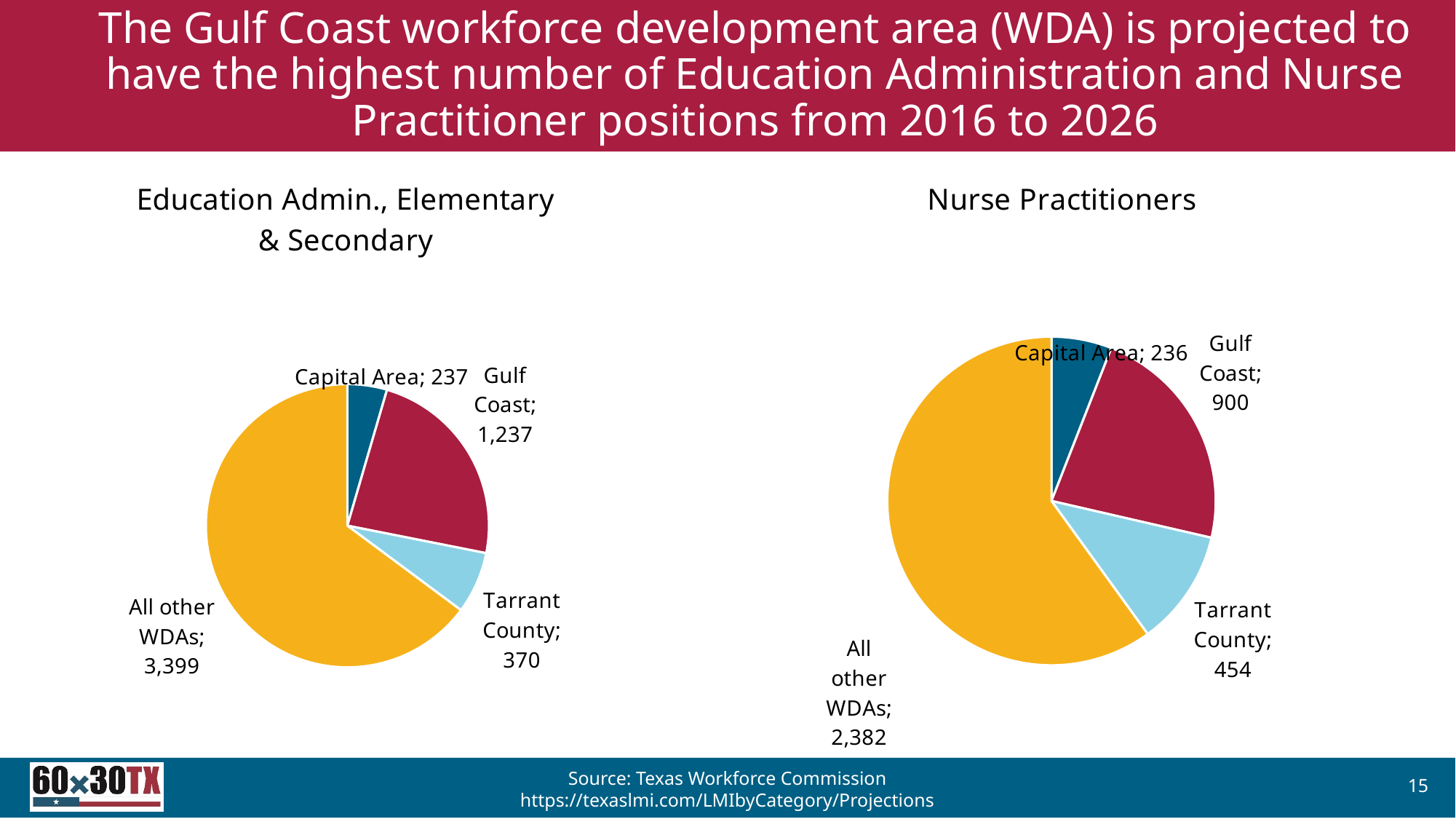
In the Education Admin., Elementary & Secondary chart, which slice is the smallest? Capital Area In the Nurse Practitioners chart, how many positions are projected for Tarrant County? 454 In the Nurse Practitioners chart, is the Gulf Coast value larger than the Tarrant County value? Yes Which is larger: Tarrant County in the Education Admin., Elementary & Secondary chart or Tarrant County in the Nurse Practitioners chart? Nurse Practitioners In the Nurse Practitioners chart, which slice is the largest? All other WDAs How many slices does the Nurse Practitioners pie chart have? 4 What is the total of all slices in the Nurse Practitioners chart? 3,972 What is the difference between the Gulf Coast values in the Education Admin., Elementary & Secondary chart and the Nurse Practitioners chart? 337 What type of chart is used for Education Admin., Elementary & Secondary? Pie chart In the Education Admin., Elementary & Secondary chart, how many positions are projected for Gulf Coast? 1,237 In the Nurse Practitioners chart, what is the value for All other WDAs? 2,382 In the Education Admin., Elementary & Secondary chart, how much larger is the Gulf Coast value than the Tarrant County value? 867